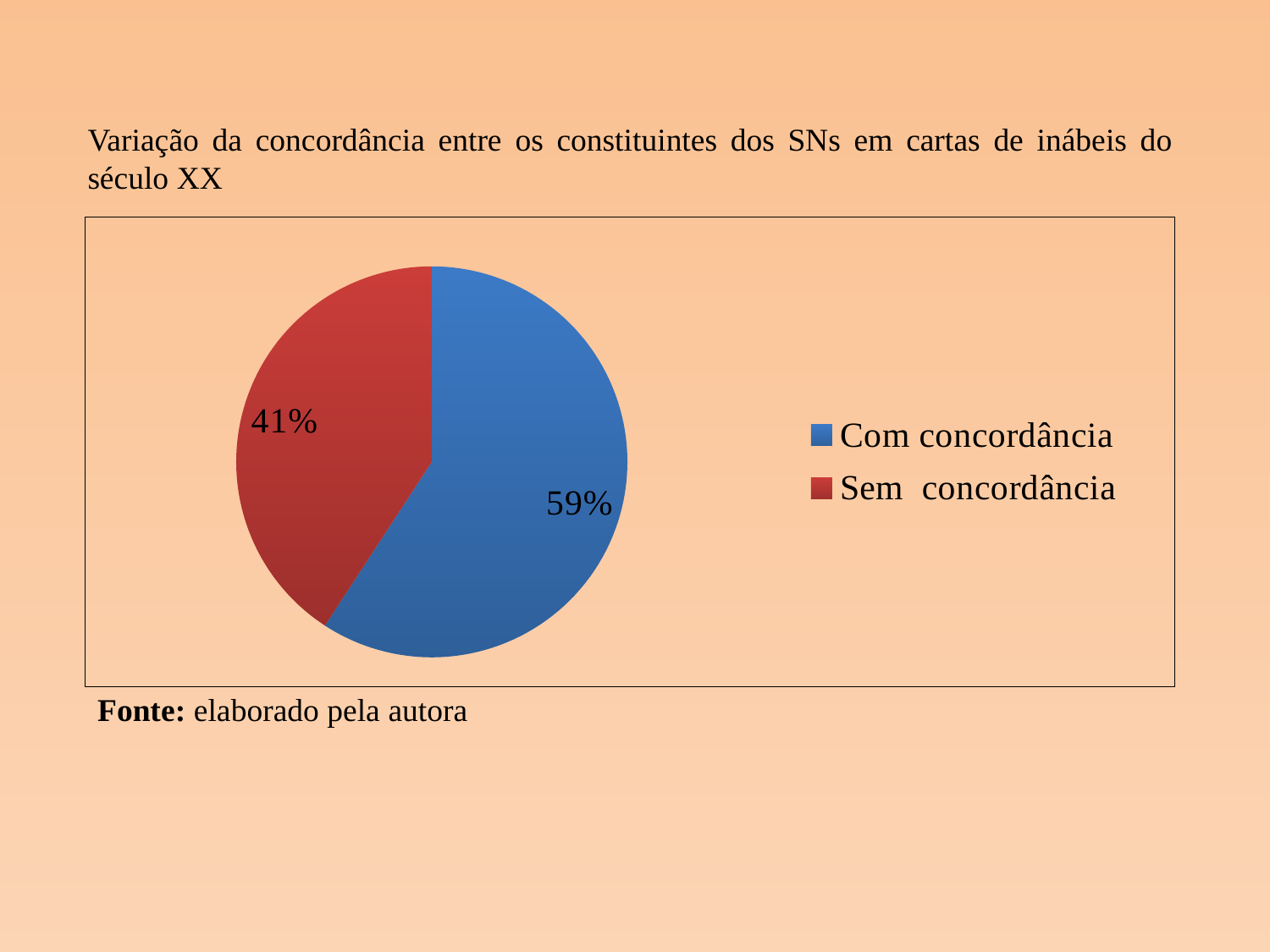
How many slices does the pie chart have? 2 What share of the pie does "Com concordância" represent? 59% What colour is the "Sem concordância" slice? red What colour is the "Com concordância" slice? blue Which slice is the largest? Com concordância Which slice is the smallest? Sem concordância Which is larger, "Com concordância" or "Sem concordância"? Com concordância What kind of chart is shown on the slide? pie chart How many entries does the legend list? 2 What is the difference in percentage points between "Com concordância" and "Sem concordância"? 18 What share of the pie does "Sem concordância" represent? 41%